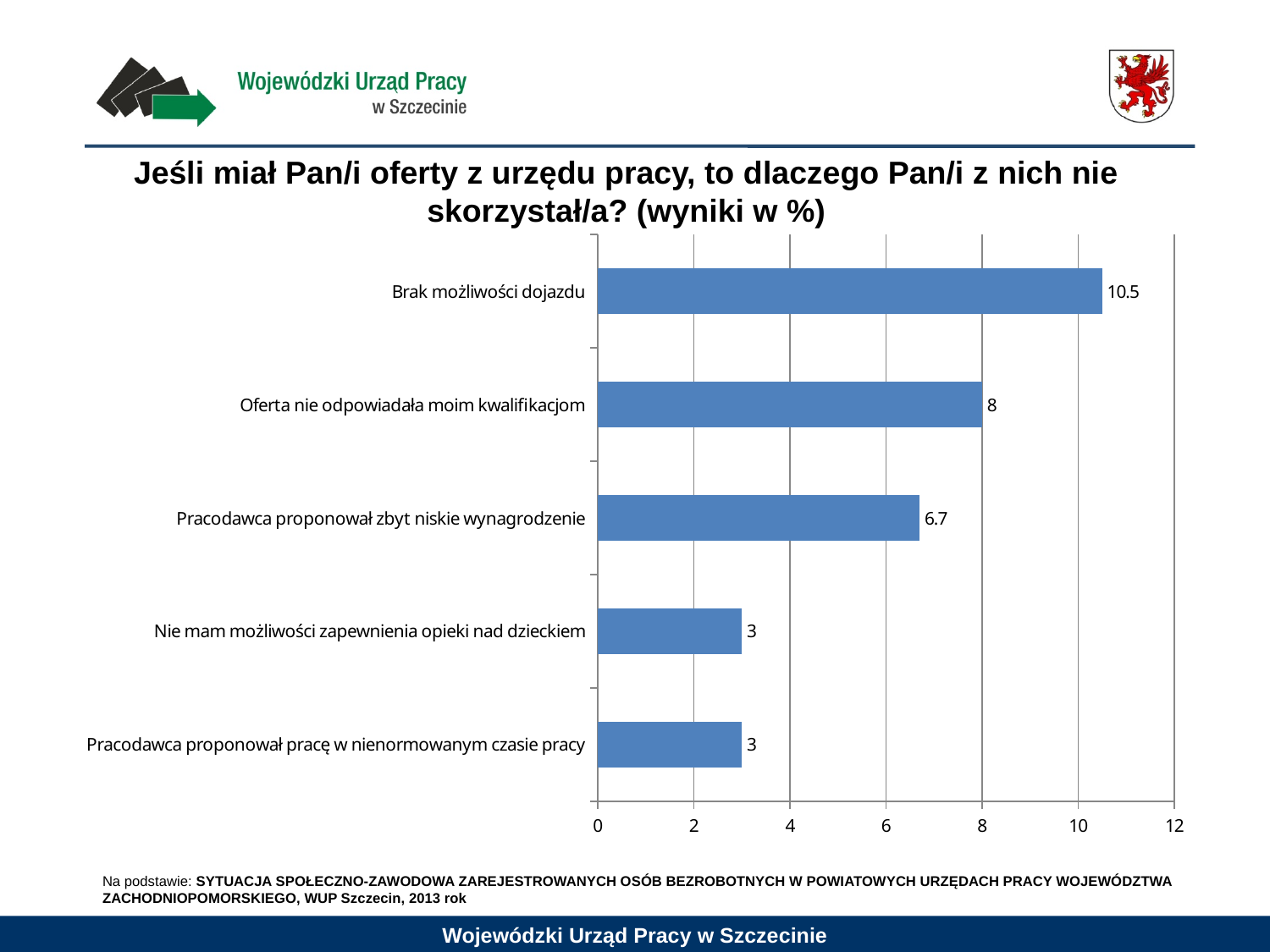
What is the maximum value shown on the horizontal axis? 12 What kind of chart is shown on the slide? bar chart Is the value for "Brak możliwości dojazdu" greater or less than 10? greater What is the difference between the values for "Brak możliwości dojazdu" and "Oferta nie odpowiadała moim kwalifikacjom"? 2.5 How many categories are shown in the chart? 5 What is the value for "Brak możliwości dojazdu"? 10.5 Which is larger: the value for "Pracodawca proponował zbyt niskie wynagrodzenie" or the value for "Nie mam możliwości zapewnienia opieki nad dzieckiem"? Pracodawca proponował zbyt niskie wynagrodzenie What is the value for "Pracodawca proponował zbyt niskie wynagrodzenie"? 6.7 What is the value for "Oferta nie odpowiadała moim kwalifikacjom"? 8 What is the value for "Nie mam możliwości zapewnienia opieki nad dzieckiem"? 3 Which category has the highest value? Brak możliwości dojazdu What is the difference between the values for "Oferta nie odpowiadała moim kwalifikacjom" and "Pracodawca proponował zbyt niskie wynagrodzenie"? 1.3